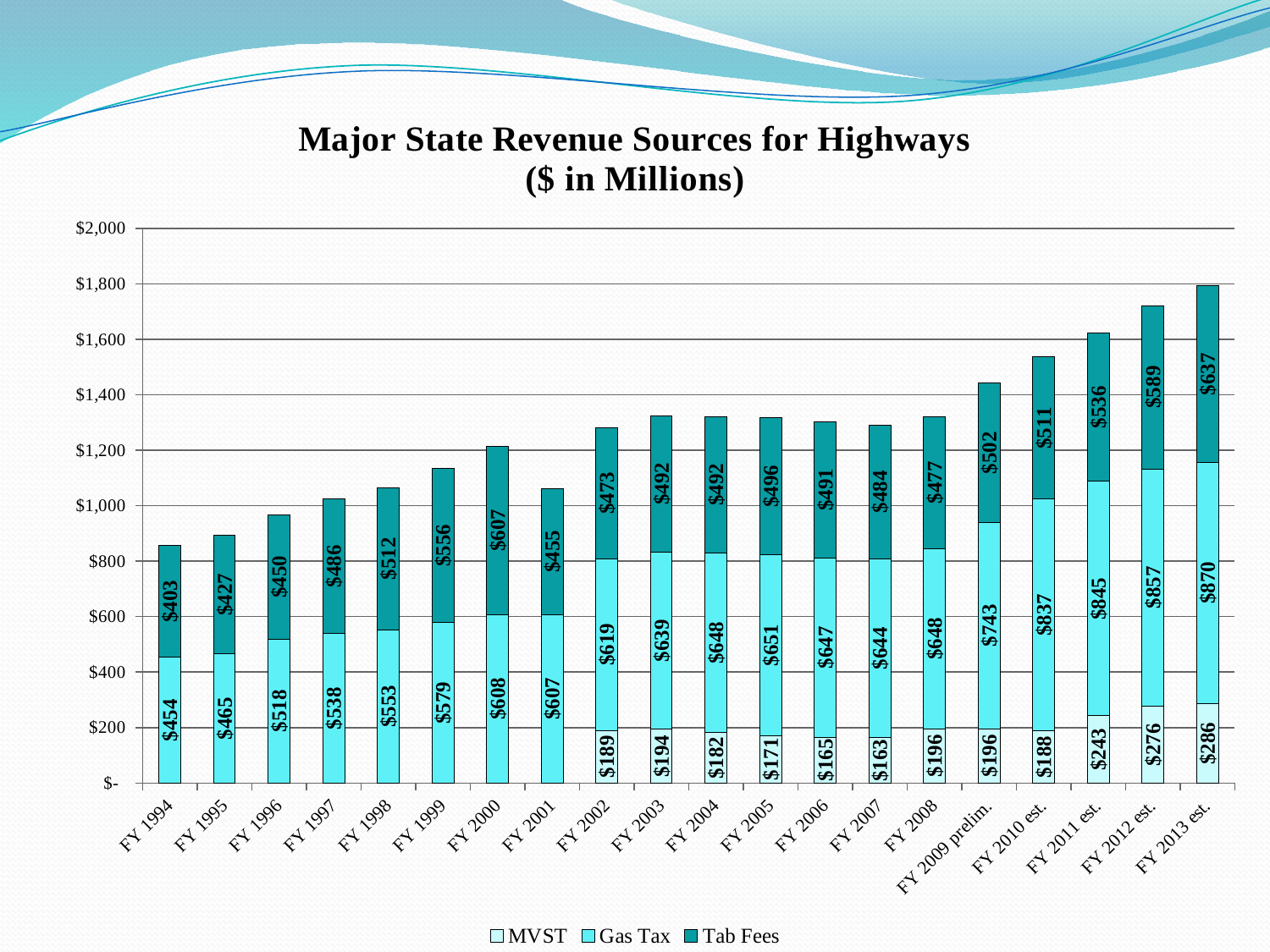
What kind of chart is shown on the slide? Stacked bar chart How many series does the legend list? 3 What is the Gas Tax value for FY 2013 est.? $870 Which is larger, the Tab Fees value for FY 2000 or for FY 2001? FY 2000 Is the total of the stacked bar for FY 1994 greater or less than $1,000? less What is the difference between the Tab Fees values for FY 2013 est. and FY 2012 est.? $48 What is the MVST value for FY 2007? $163 How many fiscal years are shown along the x axis? 20 What is the total of the stacked bar for FY 2013 est.? $1,793 Which fiscal year has the lowest Tab Fees value? FY 1994 Which fiscal year has the highest Tab Fees value? FY 2013 est. What is the Tab Fees value for FY 2000? $607